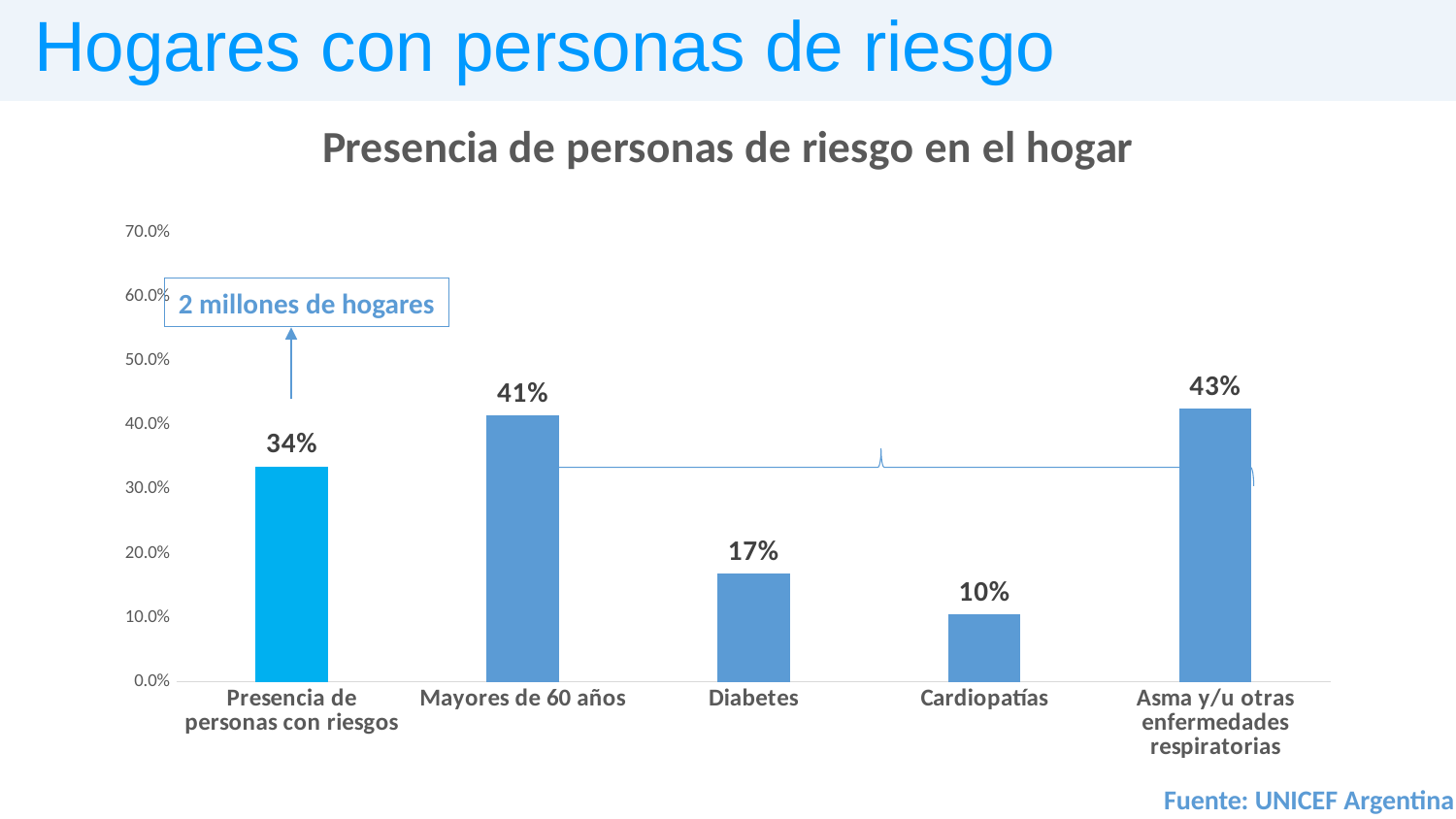
What is the difference between the values for Asma y/u otras enfermedades respiratorias and Mayores de 60 años? 2% What is the value for Mayores de 60 años? 41% What is the value for Diabetes? 17% How many categories are shown in the chart? 5 Which category has the lowest value? Cardiopatías Is the value for Mayores de 60 años greater or less than 50.0%? less What kind of chart is shown on the slide? bar chart Which is larger, the value for Diabetes or the value for Cardiopatías? Diabetes What is the title of the chart? Presencia de personas de riesgo en el hogar What is the value for Presencia de personas con riesgos? 34% Which category has the highest value? Asma y/u otras enfermedades respiratorias What is the value for Cardiopatías? 10%